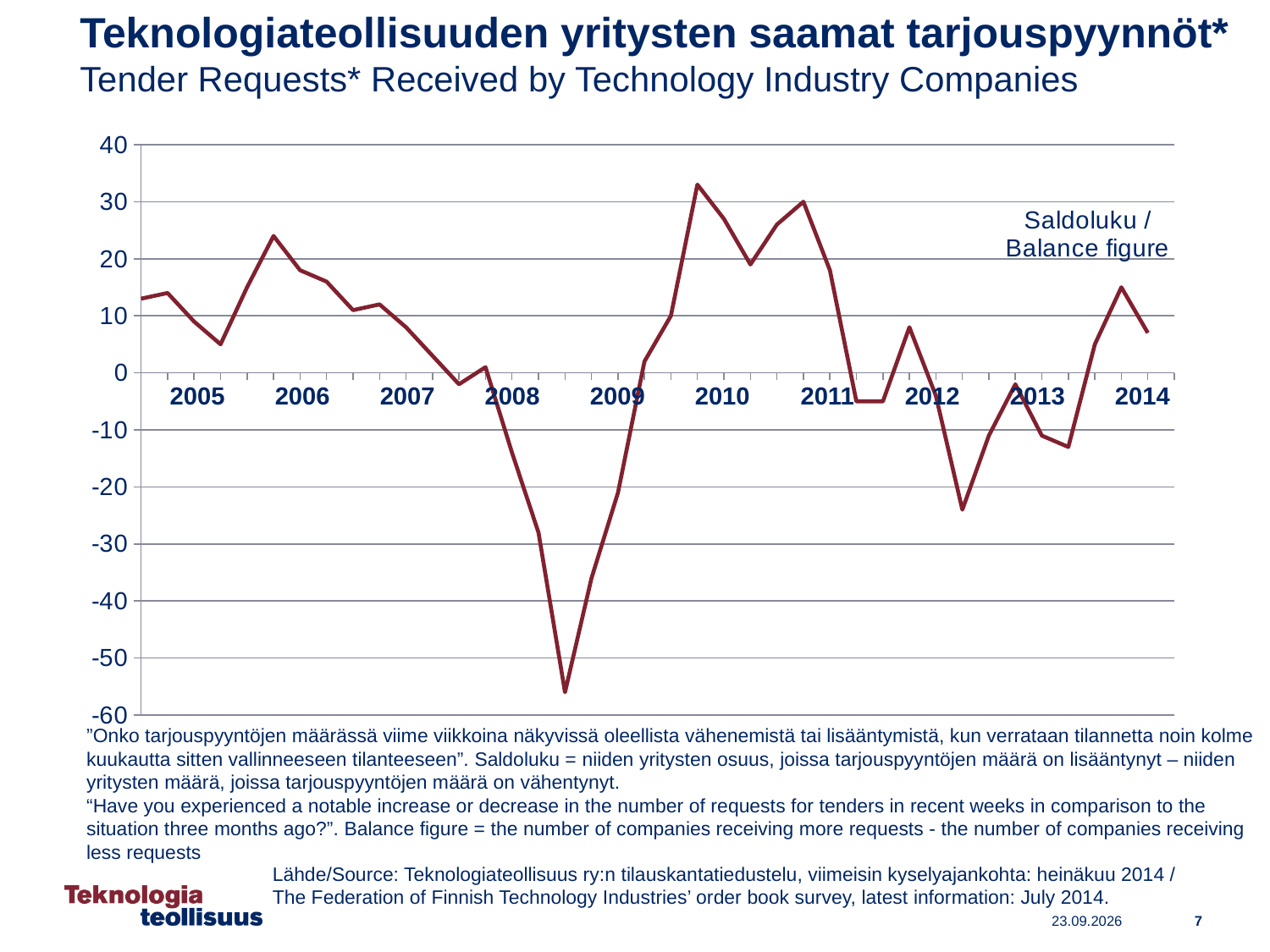
Is the first value of the line at the start of 2005 greater or less than 10? greater What is the lowest value shown on the y axis of the chart? -60 Does the line rise or fall from the start of 2008 to its lowest point around the start of 2009? fall Is the last value of the line in 2014 greater or less than 10? less Is the peak of the line in 2006 greater or less than 20? greater How many year labels are shown on the x axis of the chart? 10 What kind of chart is shown on the slide? line chart